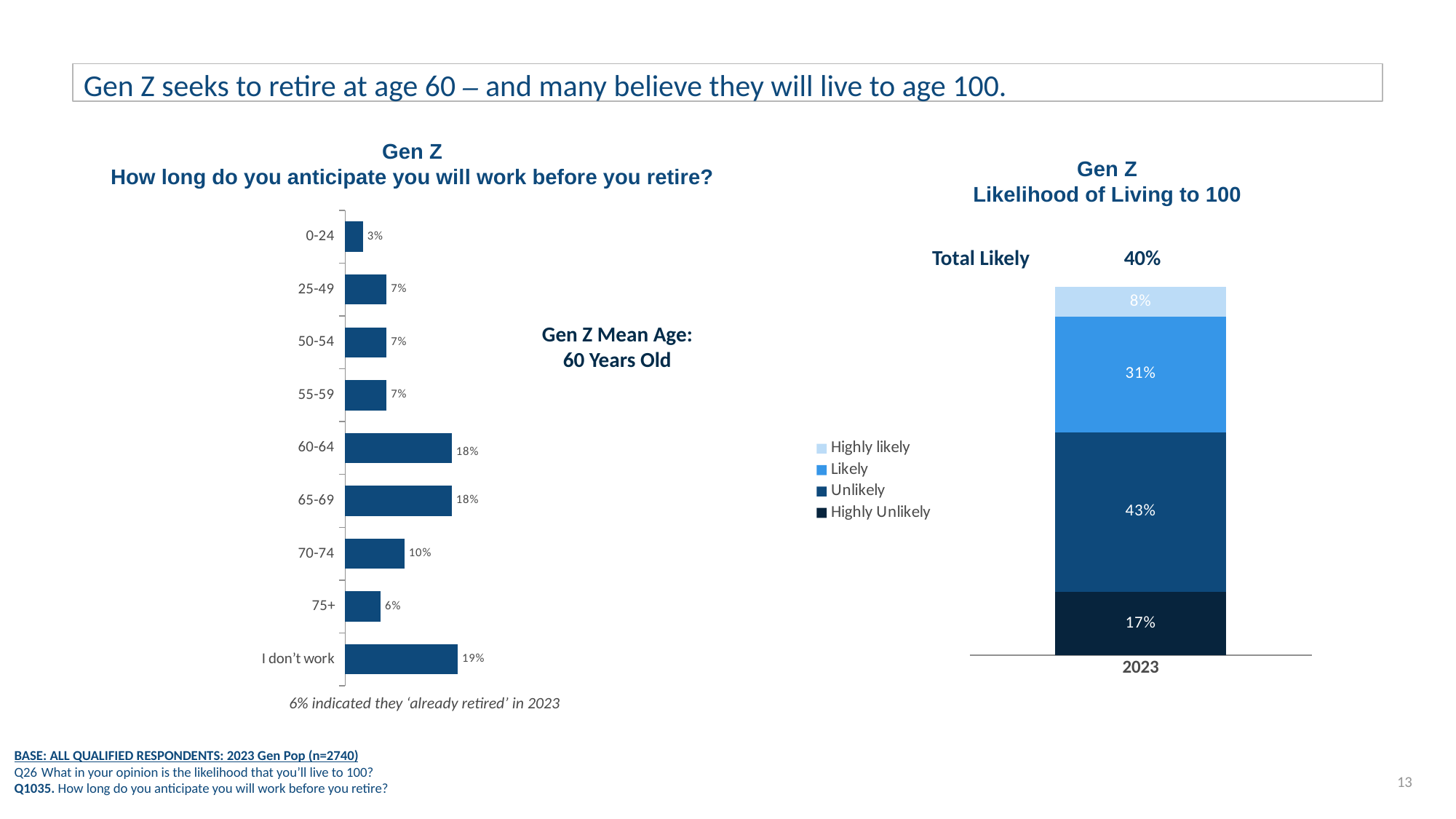
In the 'How long do you anticipate you will work before you retire?' chart, which is larger, the value for 25-49 or the value for 70-74? 70-74 In the 'Likelihood of Living to 100' chart, what is the combined value of Unlikely and Highly Unlikely? 60% In the 'Likelihood of Living to 100' chart, what is the value for Highly likely? 8% How many series does the legend of the 'Likelihood of Living to 100' chart list? 4 In the 'How long do you anticipate you will work before you retire?' chart, what is the value for 60-64? 18% In the 'Likelihood of Living to 100' chart, what is the value for Unlikely? 43% In the 'How long do you anticipate you will work before you retire?' chart, what is the value for 'I don't work'? 19% In the 'How long do you anticipate you will work before you retire?' chart, which category has the lowest value? 0-24 How many categories are shown in the 'How long do you anticipate you will work before you retire?' chart? 9 What kind of chart is the 'How long do you anticipate you will work before you retire?' chart? Bar chart In the 'How long do you anticipate you will work before you retire?' chart, what is the difference between the values for 70-74 and 75+? 4% In the 'How long do you anticipate you will work before you retire?' chart, which category has the highest value? I don't work